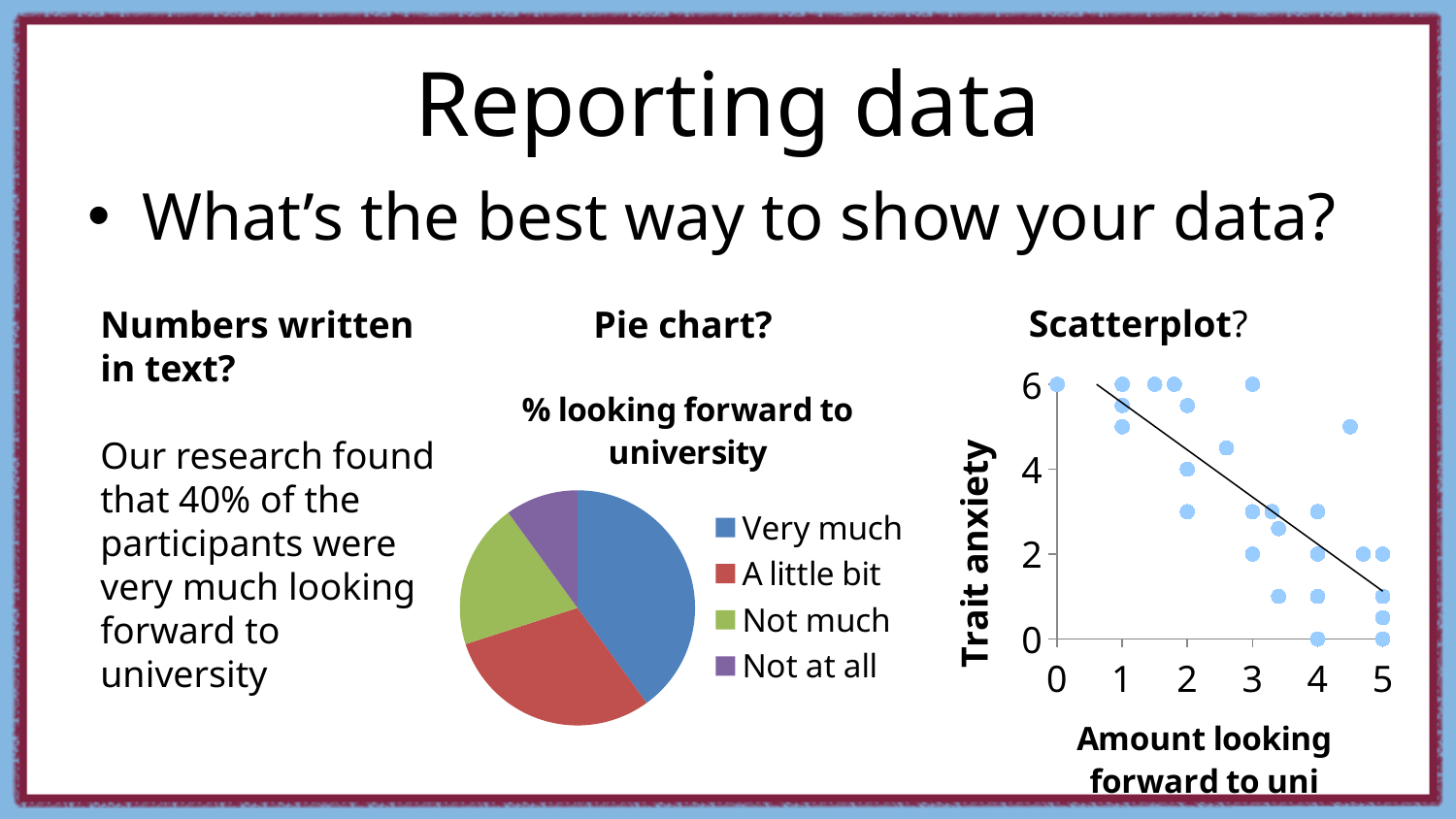
In the pie chart titled "% looking forward to university", how many categories does the legend list? 4 What kind of chart is the chart titled "% looking forward to university"? pie chart In the pie chart titled "% looking forward to university", which category has the largest slice? Very much In the pie chart titled "% looking forward to university", which slice is larger: "Not much" or "Not at all"? Not much In the pie chart titled "% looking forward to university", which slice is larger: "Very much" or "Not much"? Very much What kind of chart is the chart on the right of the slide, under the heading "Scatterplot?"? scatter plot In the scatterplot on the right of the slide, what is the highest tick value shown on the vertical axis? 6 What is the label of the horizontal axis of the scatterplot on the right of the slide? Amount looking forward to uni In the pie chart titled "% looking forward to university", which category has the smallest slice? Not at all In the scatterplot on the right of the slide, do the values of Trait anxiety generally rise or fall as Amount looking forward to uni increases? fall